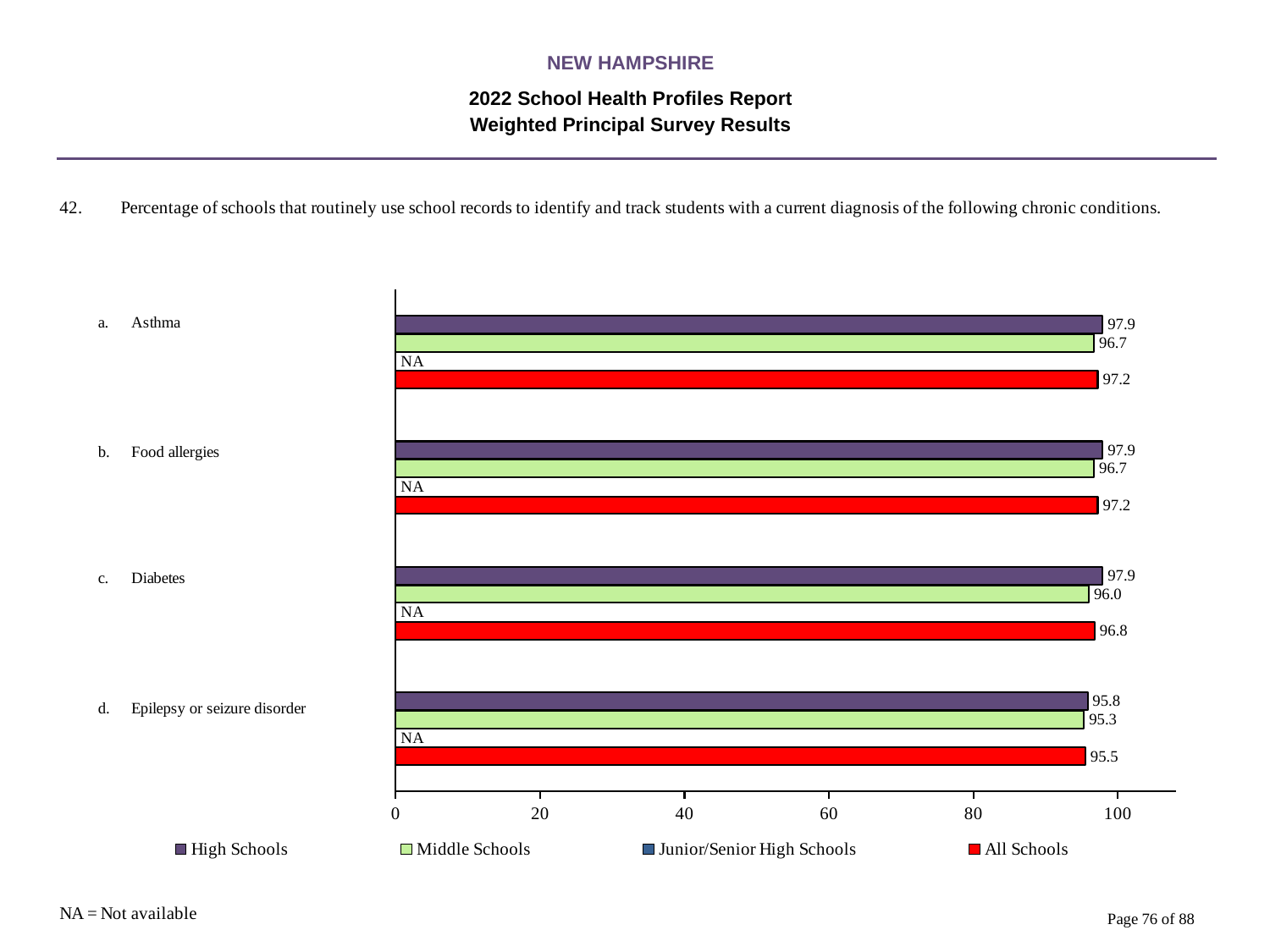
Which is larger for Epilepsy or seizure disorder: the High Schools value or the Middle Schools value? High Schools What is the difference between the All Schools values for Asthma and Epilepsy or seizure disorder? 1.7 What is the High Schools value for Asthma? 97.9 How many chronic conditions are listed on the chart? 4 What is the All Schools value for Epilepsy or seizure disorder? 95.5 What is the Middle Schools value for Diabetes? 96.0 What is the Junior/Senior High Schools value for Food allergies? NA Which condition has the lowest All Schools value? Epilepsy or seizure disorder What is the difference between the High Schools and Middle Schools values for Diabetes? 1.9 Which condition has the lowest Middle Schools value? Epilepsy or seizure disorder How many series does the legend list? 4 What kind of chart is shown on the slide? Bar chart